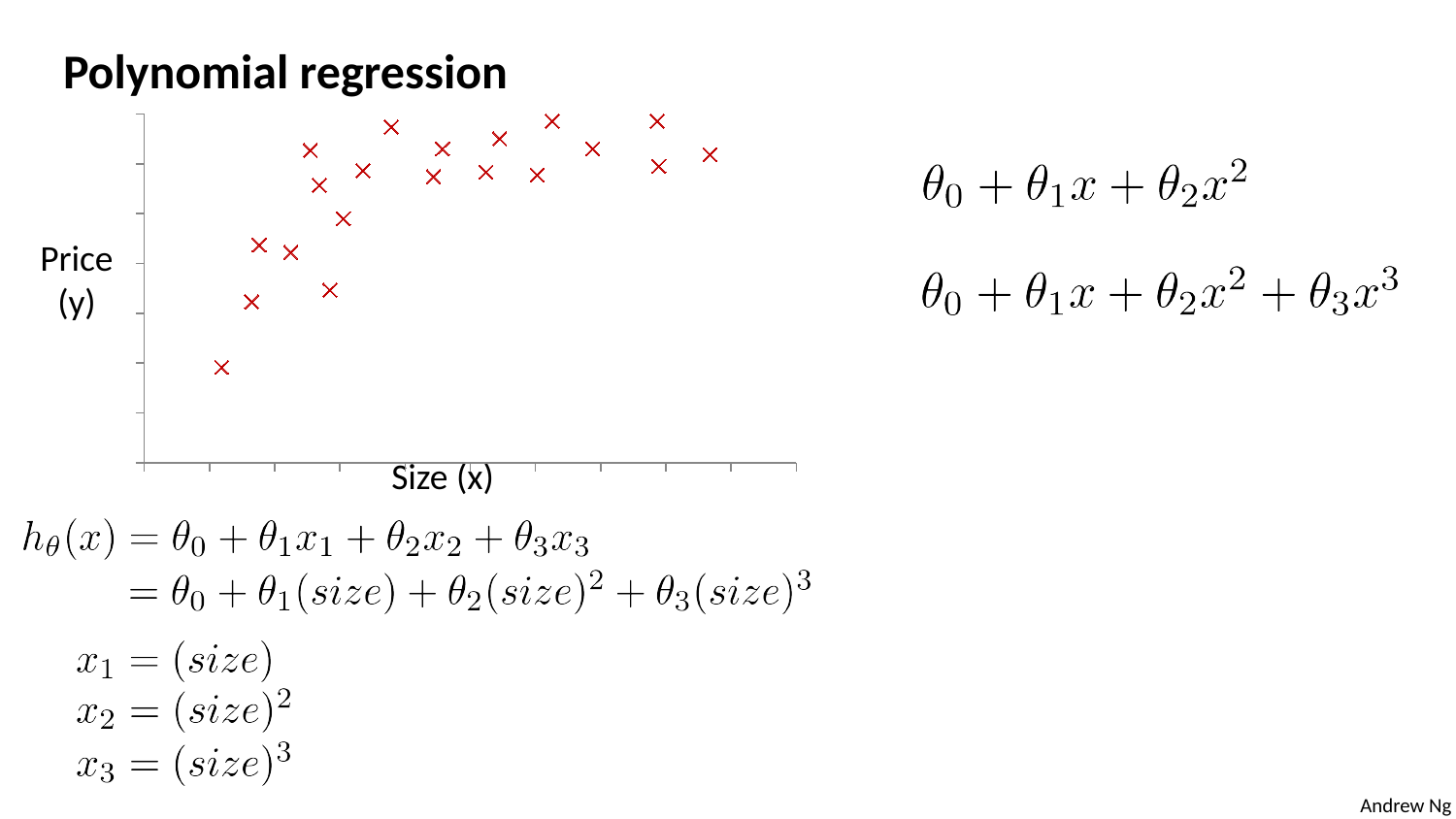
What is the label of the y axis of the chart? Price (y) What kind of chart is shown on the slide? scatter plot What is the label of the x axis of the chart? Size (x) Is the point with the lowest Price located at the left end or the right end of the x axis? left end Which has the higher Price: the leftmost point or the rightmost point? the rightmost point Do the plotted Price values generally rise or fall as Size increases along the x axis? rise How many data points are plotted on the chart? 20